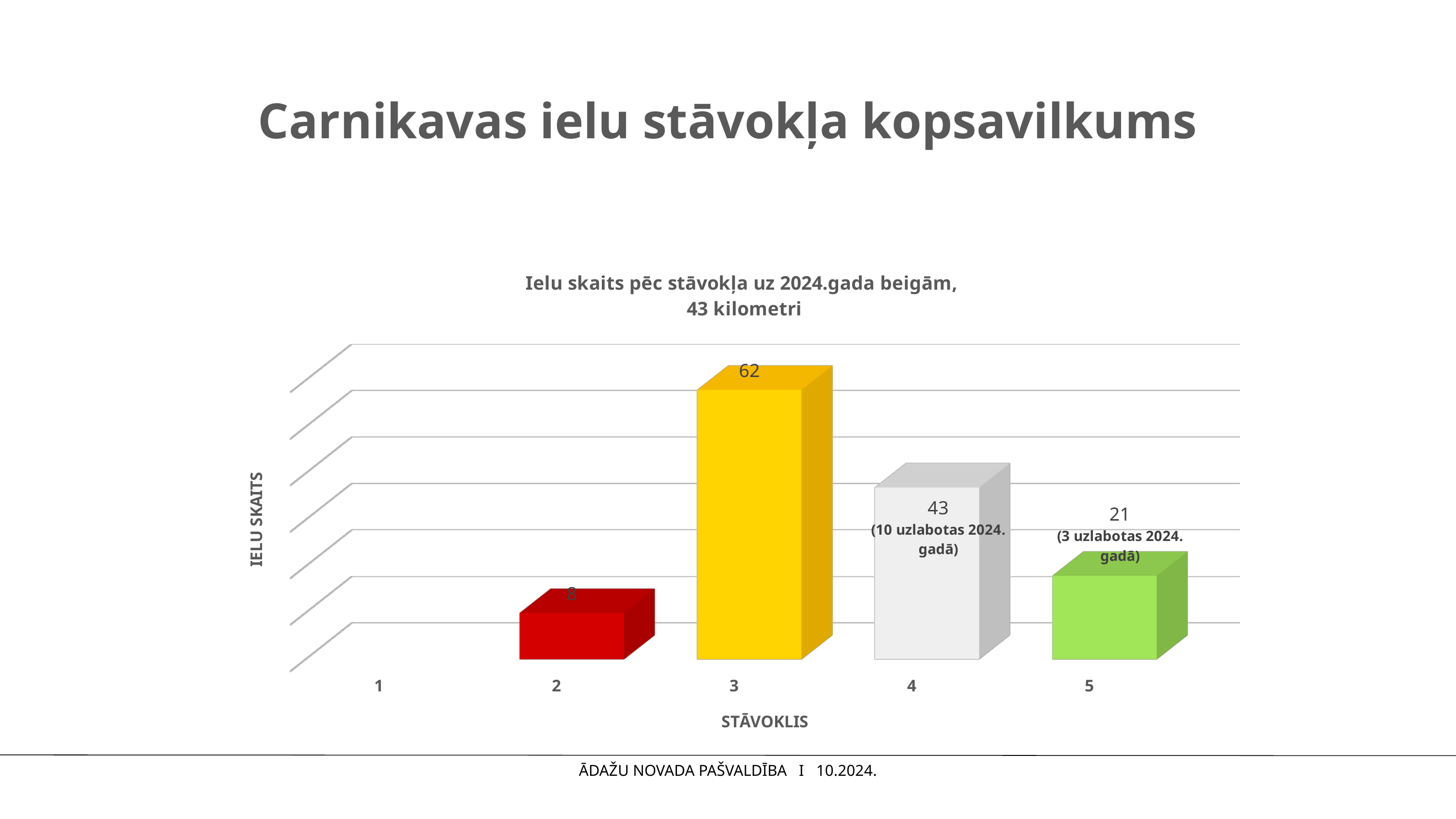
How many categories are shown on the x axis? 5 What is the difference between the values for category 4 and category 5? 22 What is the title of the x axis? STĀVOKLIS What is the value for category 5? 21 What is the value for category 4? 43 Which category has the highest value? 3 What kind of chart is shown on the slide? bar chart Which is larger, the value for category 4 or the value for category 5? category 4 What is the value for category 3? 62 What is the difference between the values for category 3 and category 4? 19 What is the value for category 2? 8 Among categories 2 to 5, which has the lowest value? 2